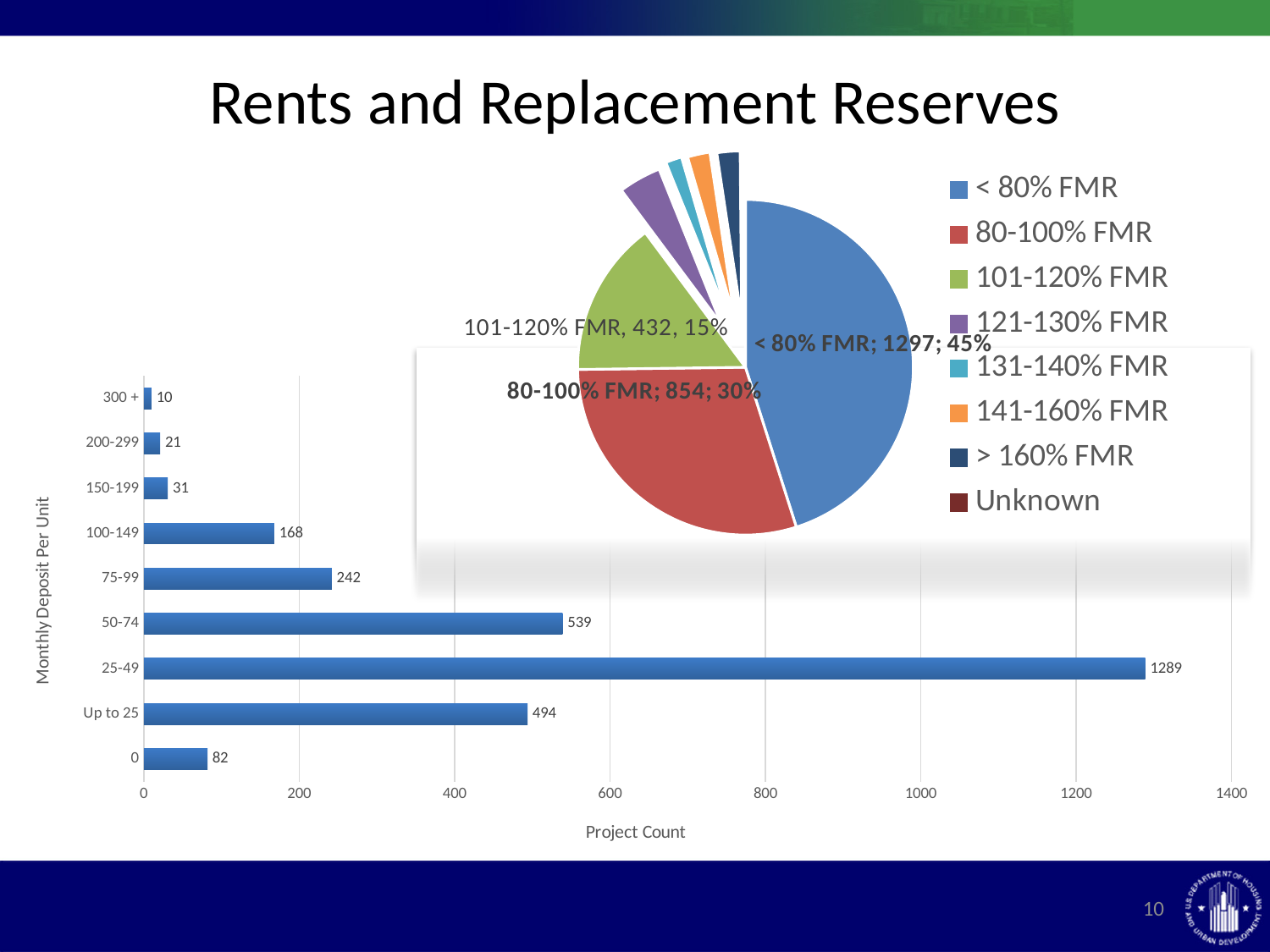
In the pie chart, what value and share are shown for the < 80% FMR slice? 1297; 45% In the bar chart, what is the difference in project count between the Up to 25 and 0 categories? 412 In the pie chart, what share does the 80-100% FMR slice represent? 30% How many entries does the pie chart's legend list? 8 How many monthly deposit categories are shown in the bar chart? 9 In the bar chart, which monthly deposit category has the lowest project count? 300 + In the bar chart, what is the project count for the 300 + monthly deposit category? 10 In the bar chart, which monthly deposit category has the highest project count? 25-49 What type of chart is the chart with the Project Count axis? bar chart In the bar chart, what is the project count for the 50-74 monthly deposit category? 539 In the bar chart, which has a larger project count: 75-99 or 100-149? 75-99 In the bar chart, what is the project count for the 25-49 monthly deposit category? 1289